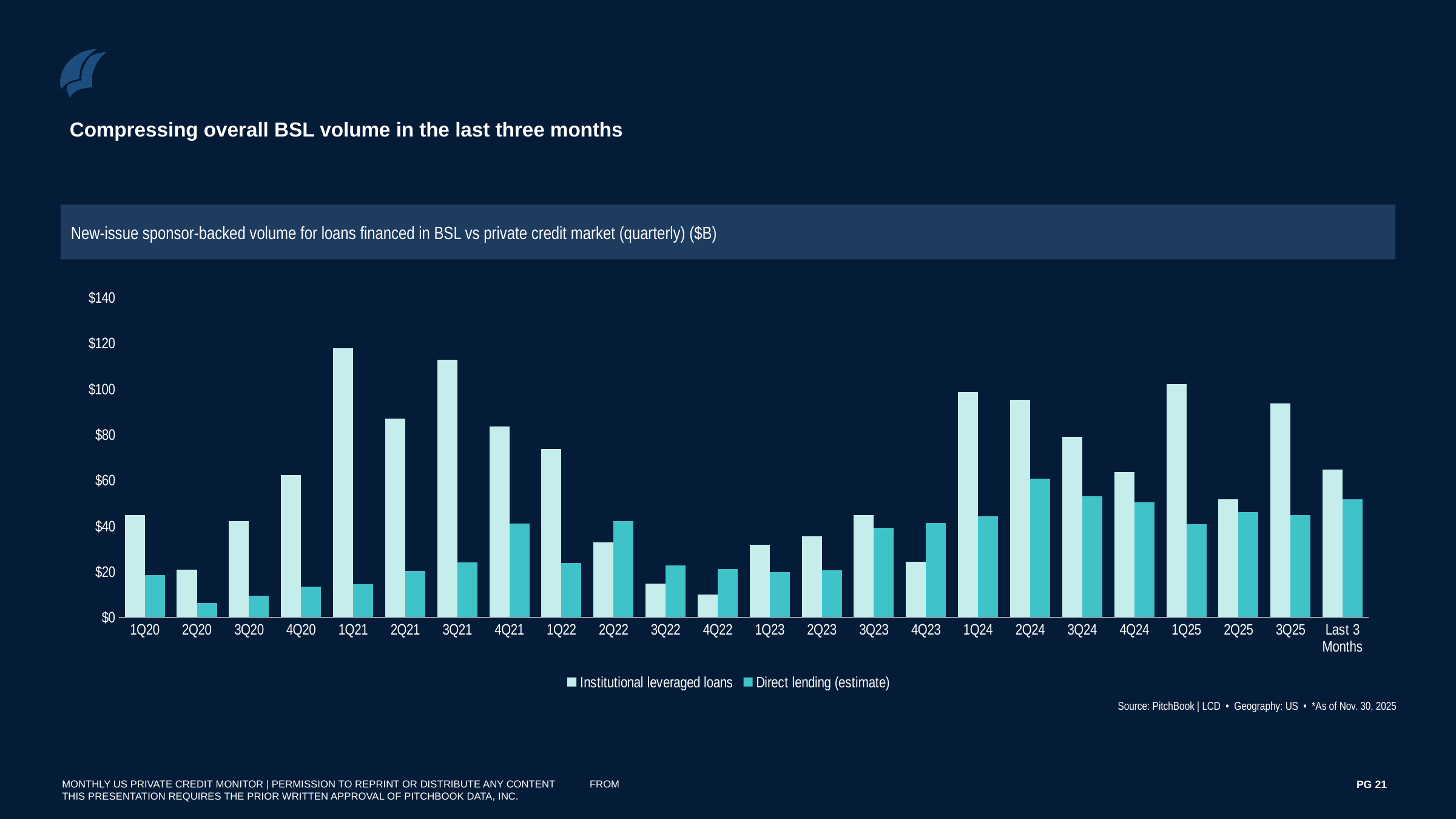
Which quarter has the highest value for Direct lending (estimate)? 2Q24 Which quarter has the lowest value for Direct lending (estimate)? 2Q20 Is the value for Institutional leveraged loans in 1Q21 greater or less than $100? greater How many series does the legend list? 2 What kind of chart is shown on the slide? Bar chart How many categories are shown along the x axis? 24 Do the values for Institutional leveraged loans rise or fall from 1Q21 to 4Q22? fall Is the value for Direct lending (estimate) in 2Q20 greater or less than $20? less Which quarter has the lowest value for Institutional leveraged loans? 4Q22 Which quarter has the highest value for Institutional leveraged loans? 1Q21 In 4Q23, which series has the larger value: Institutional leveraged loans or Direct lending (estimate)? Direct lending (estimate) Is the value for Institutional leveraged loans in 3Q25 greater or less than $80? greater